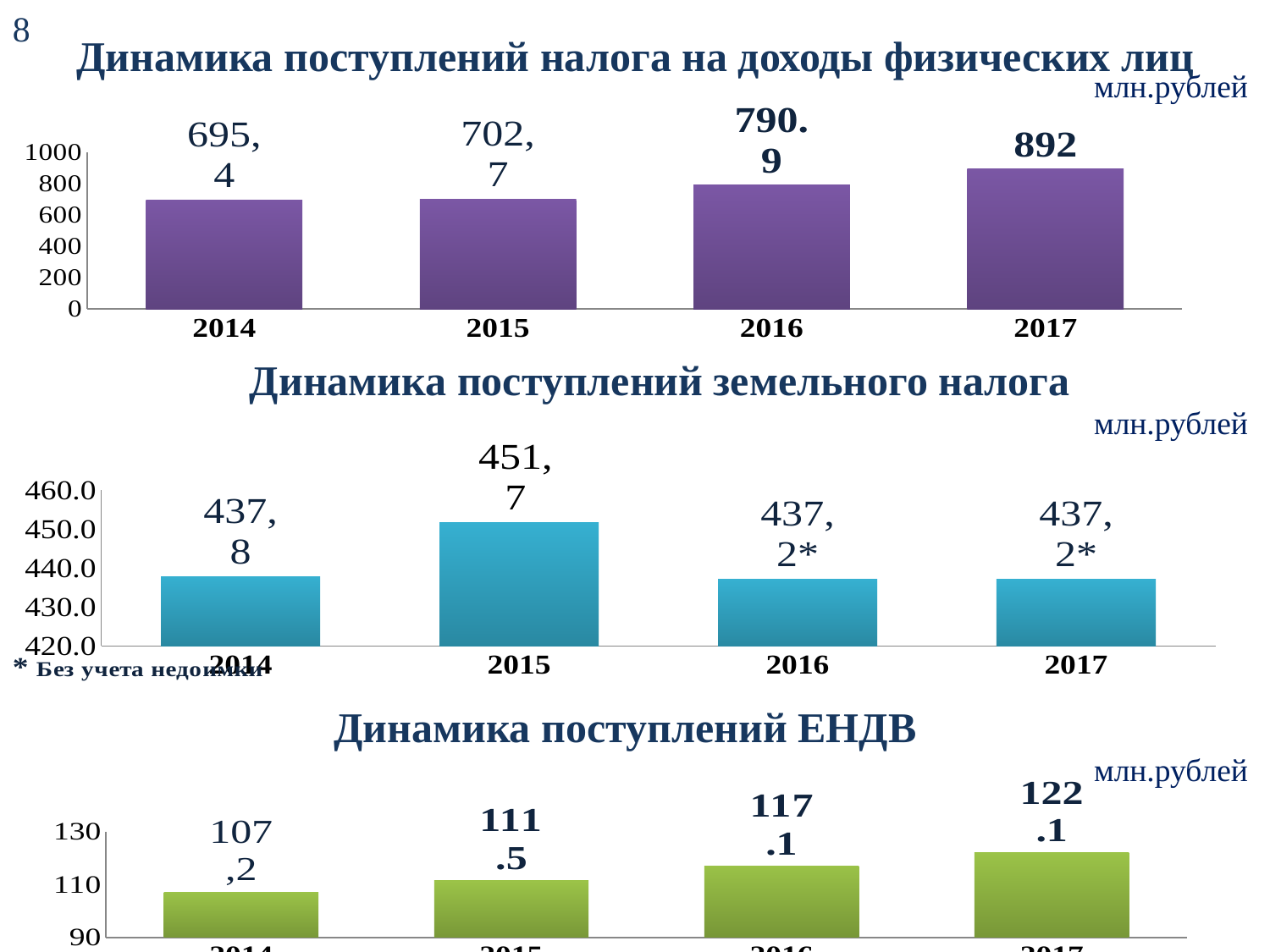
In the bottom chart (Динамика поступлений ЕНДВ), do the values rise or fall from left to right? rise What kind of chart is the top chart (Динамика поступлений налога на доходы физических лиц)? bar chart In the middle chart (Динамика поступлений земельного налога), what is the value for 2015? 451,7 In the top chart (Динамика поступлений налога на доходы физических лиц), which year has the lowest value? 2014 In the middle chart (Динамика поступлений земельного налога), is the value for 2015 greater or less than 450.0? greater In the bottom chart (Динамика поступлений ЕНДВ), what is the value of the rightmost bar (2017)? 122.1 In the top chart (Динамика поступлений налога на доходы физических лиц), what is the value for 2017? 892 In the top chart (Динамика поступлений налога на доходы физических лиц), do the values rise or fall from 2014 to 2017? rise In the middle chart (Динамика поступлений земельного налога), which year has the highest value? 2015 In the top chart (Динамика поступлений налога на доходы физических лиц), which year has the highest value? 2017 In the top chart (Динамика поступлений налога на доходы физических лиц), how many years are shown? 4 In the middle chart (Динамика поступлений земельного налога), by how much does the 2015 value exceed the 2014 value? 13,9